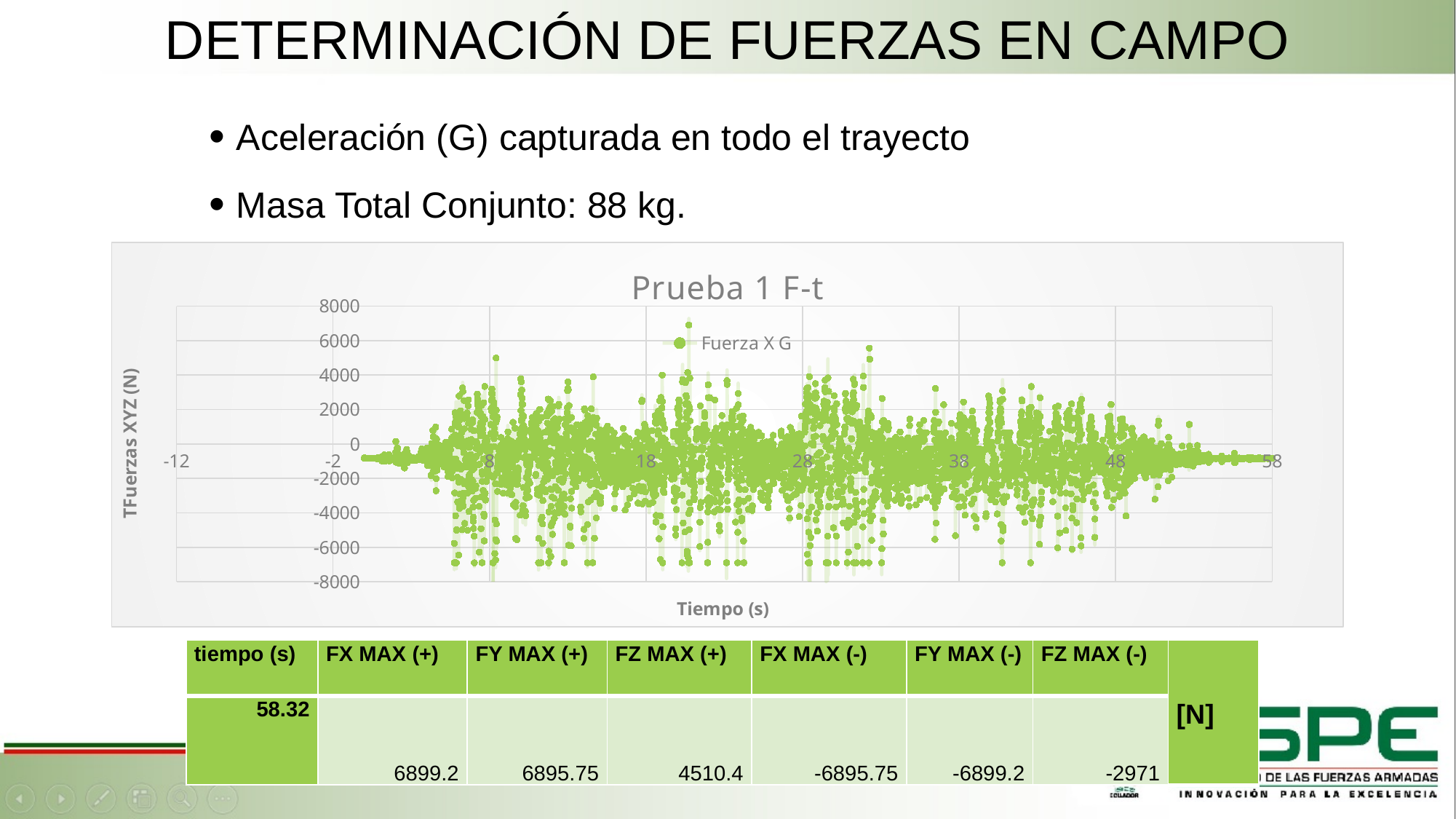
What is the last tick value shown on the x axis of the chart? 58 What is the highest tick value shown on the y axis of the chart? 8000 What is the name of the series shown in the chart legend? Fuerza X G What is the title of the chart? Prueba 1 F-t Is the highest plotted value of the Fuerza X G series greater or less than 6000? greater How many series does the chart legend list? 1 What kind of chart is shown on the slide? scatter chart What is the label of the x axis of the chart? Tiempo (s) What is the lowest tick value shown on the y axis of the chart? -8000 What is the label of the y axis of the chart? TFuerzas XYZ (N) Is the lowest plotted value of the Fuerza X G series greater or less than -6000? less What is the first tick value shown on the x axis of the chart? -12